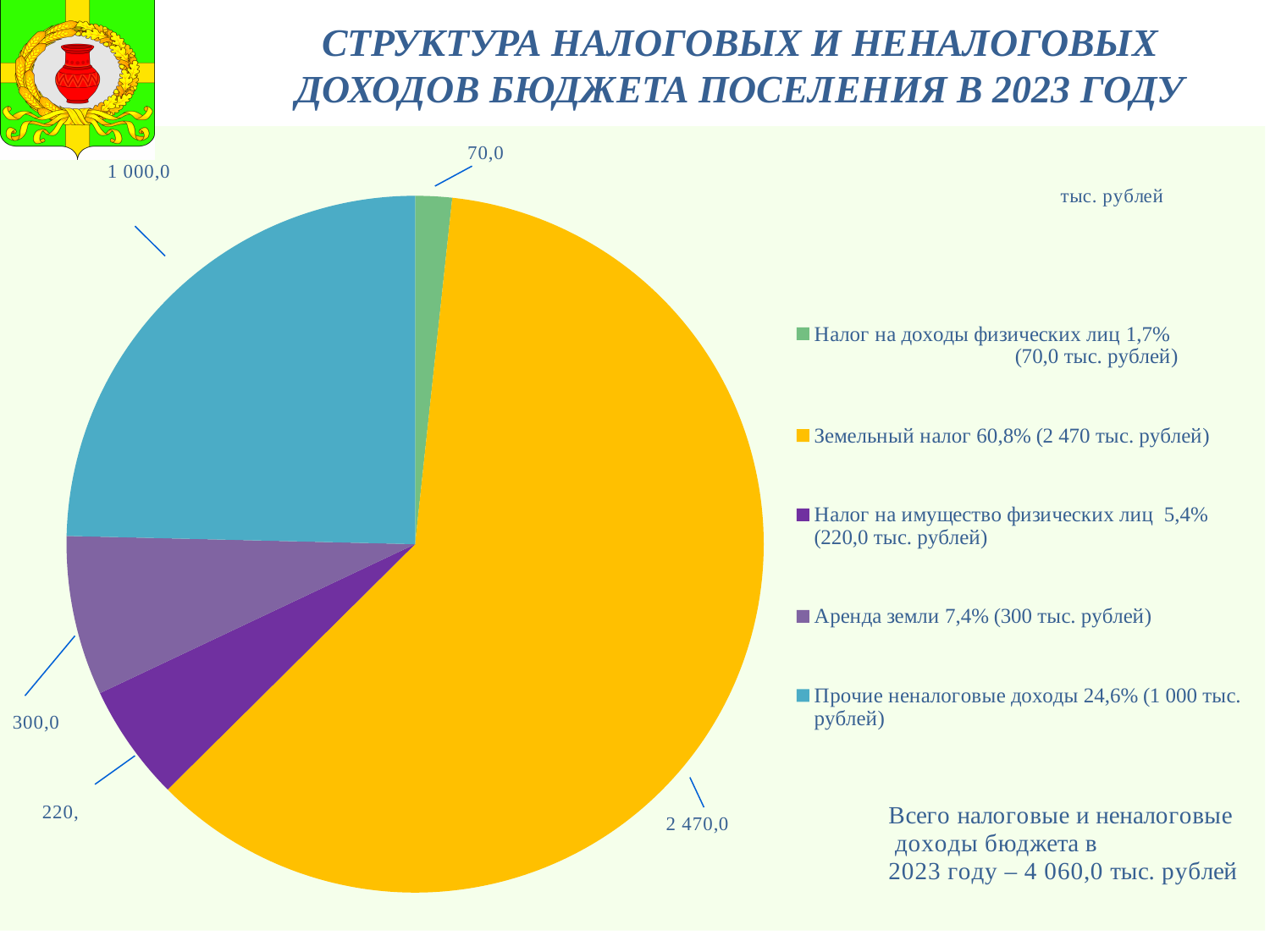
In what units are the values on the chart expressed? тыс. рублей What is the value shown for Прочие неналоговые доходы? 1 000,0 Which category has the smallest slice of the pie? Налог на доходы физических лиц How many slices does the pie chart have? 5 Which category has the largest slice of the pie? Земельный налог What is the difference between the values for Прочие неналоговые доходы and Аренда земли? 700,0 Which is larger, the value for Аренда земли or the value for Налог на имущество физических лиц? Аренда земли What share of the pie does Земельный налог represent? 60,8% What kind of chart is shown on the slide? pie chart What is the value shown for Аренда земли? 300,0 What share of the pie does Прочие неналоговые доходы represent? 24,6% What is the value shown for Земельный налог? 2 470,0